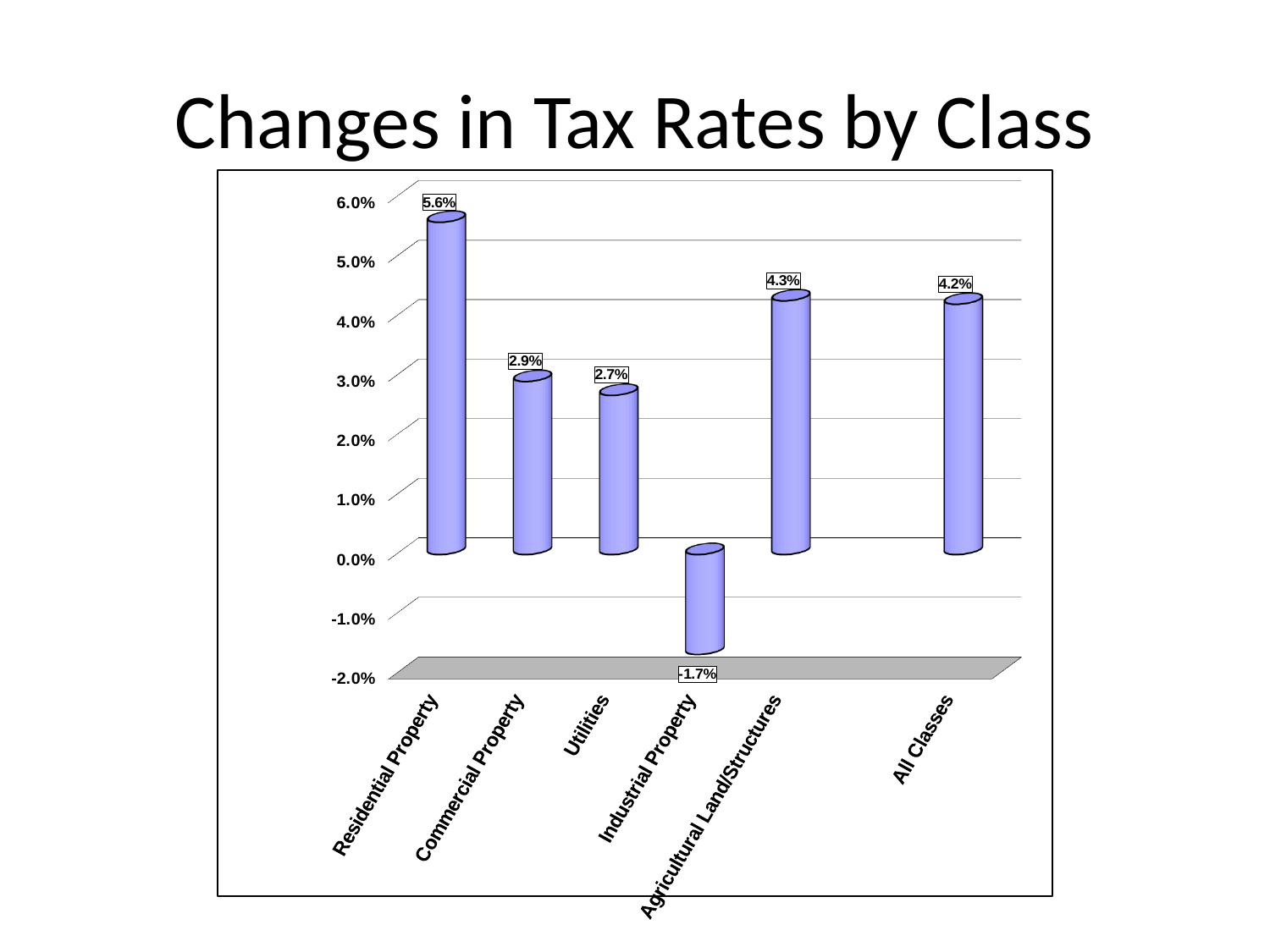
What is the title of the slide? Changes in Tax Rates by Class What kind of chart is shown on the slide? bar chart What is the change in tax rate for All Classes? 4.2% What is the change in tax rate for Industrial Property? -1.7% How many classes are shown on the chart? 6 What is the difference between the change in tax rate for Residential Property and Commercial Property? 2.7% Which class has the lowest change in tax rate? Industrial Property What is the change in tax rate for Residential Property? 5.6% Which class has the highest change in tax rate? Residential Property Which has a larger change in tax rate, Commercial Property or Utilities? Commercial Property What is the change in tax rate for Agricultural Land/Structures? 4.3% Is the value for Utilities greater or less than 3.0%? less